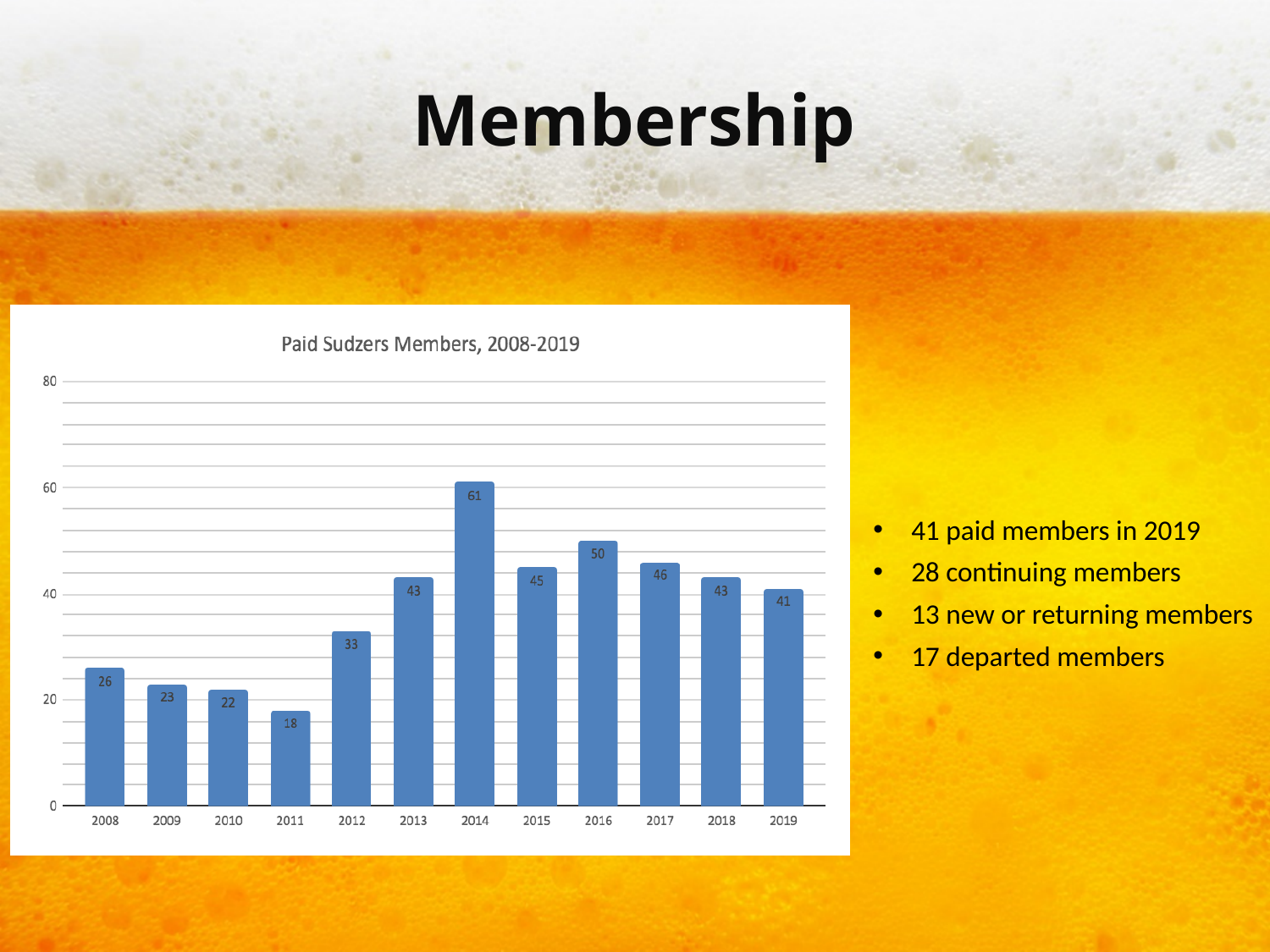
What kind of chart is shown? bar chart What is the difference between the values for 2014 and 2019? 20 Which year has the highest number of paid members? 2014 What is the value for 2019? 41 Which year has the lowest number of paid members? 2011 What is the value for 2011? 18 Which is larger, the value for 2016 or the value for 2017? 2016 What is the value for 2014? 61 How many years are shown on the x axis? 12 What is the title of the chart? Paid Sudzers Members, 2008-2019 Do the values rise or fall from 2008 to 2011? fall Is the value for 2012 greater or less than 40? less